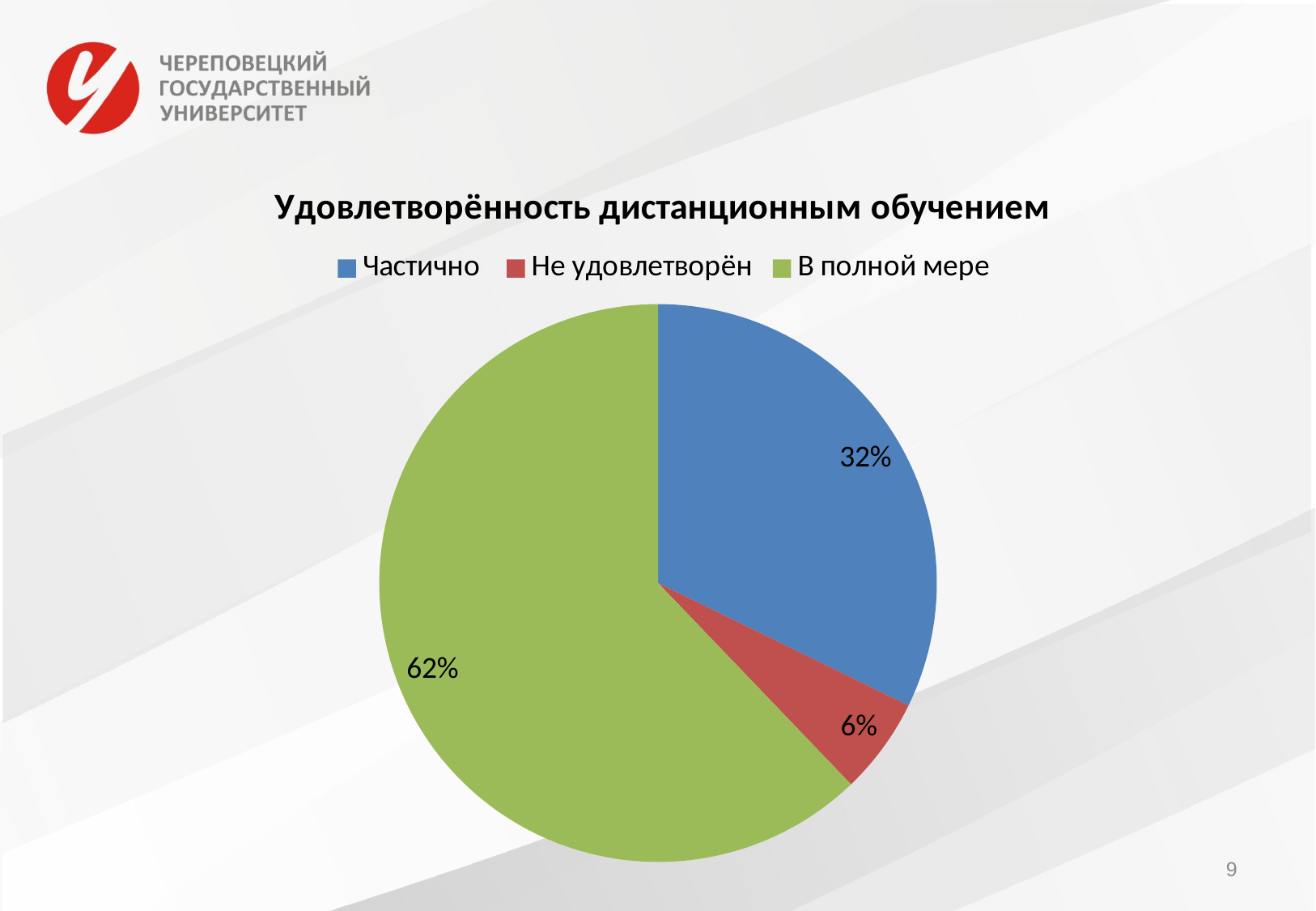
Which is larger: the share for "Частично" or the share for "Не удовлетворён"? Частично How many categories does the pie chart have? 3 What is the difference between the shares for "В полной мере" and "Частично"? 30% What colour is the slice for "Не удовлетворён"? Red Which category has the smallest slice of the pie? Не удовлетворён What is the title of the chart? Удовлетворённость дистанционным обучением What share of the pie is labelled "Частично"? 32% What share of the pie is labelled "В полной мере"? 62% Which category has the largest slice of the pie? В полной мере What is the difference between the shares for "Частично" and "Не удовлетворён"? 26% What type of chart is shown on the slide? Pie chart What share of the pie is labelled "Не удовлетворён"? 6%